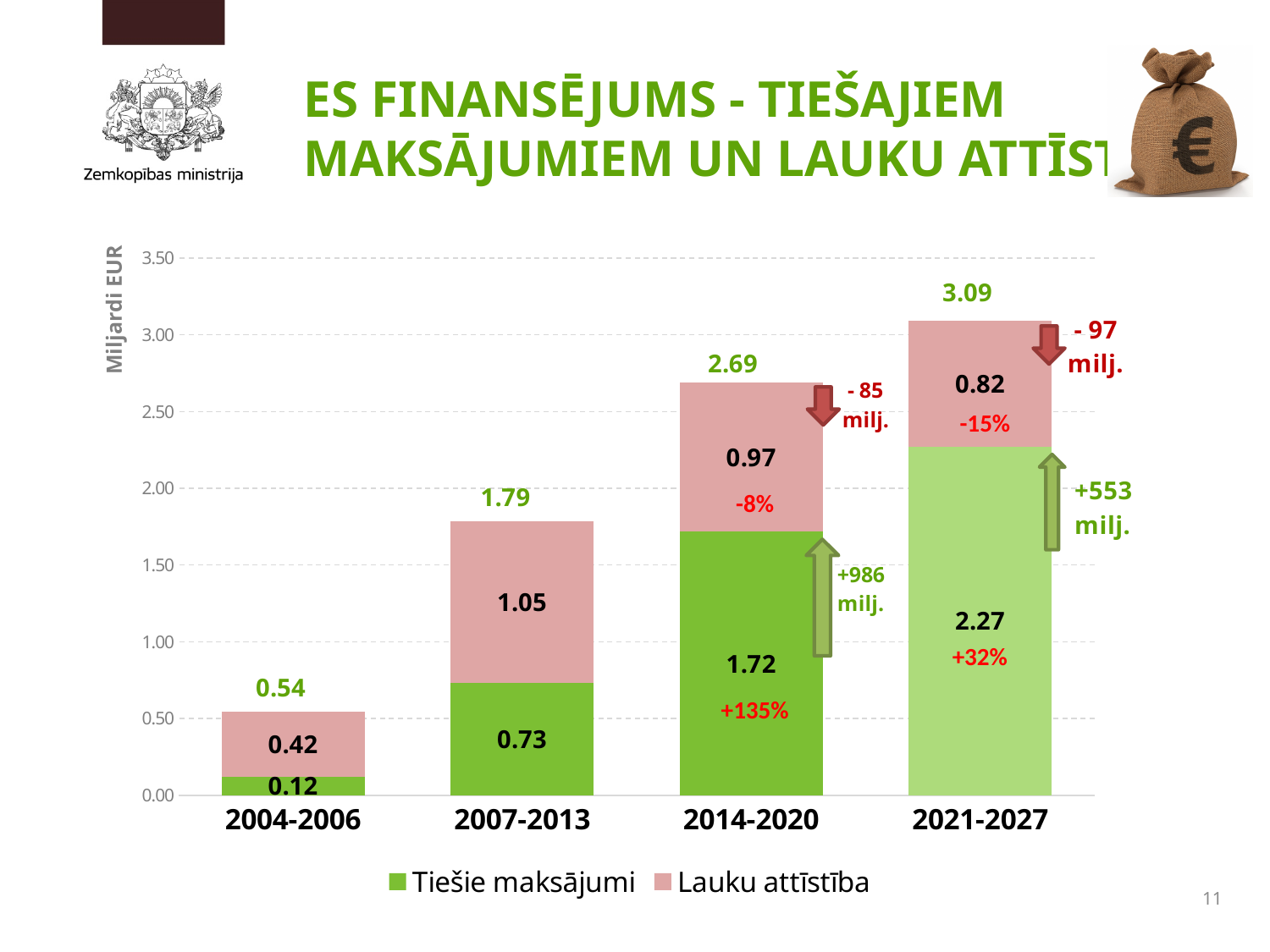
What is the total of the stacked bar for 2021-2027? 3.09 Which period has the highest value for Tiešie maksājumi? 2021-2027 What is the total of the stacked bar for 2004-2006? 0.54 How many periods are shown on the x axis? 4 How many series does the legend list? 2 What is the difference between Lauku attīstība in 2014-2020 and in 2021-2027? 0.15 What kind of chart is shown on the slide? Stacked bar chart Which is larger in 2007-2013: Tiešie maksājumi or Lauku attīstība? Lauku attīstība What is the value of Lauku attīstība for 2007-2013? 1.05 Which period has the lowest value for Lauku attīstība? 2004-2006 What is the value of Tiešie maksājumi for 2014-2020? 1.72 What is the label of the y axis? Miljardi EUR